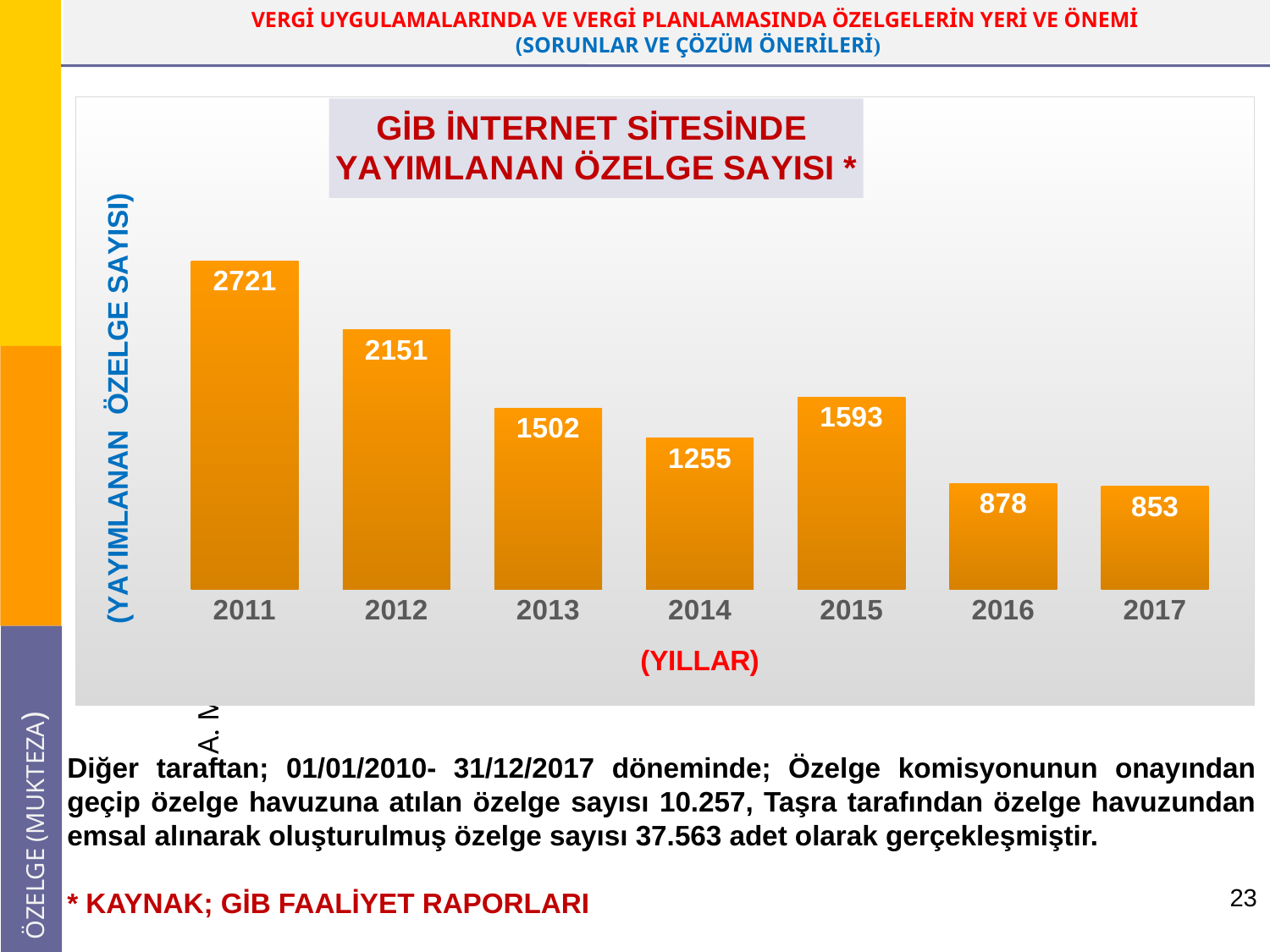
What is the value shown for 2017? 853 What kind of chart is shown on the slide? bar chart Which year has the lowest number of özelge published? 2017 What is the title of the chart? GİB İNTERNET SİTESİNDE YAYIMLANAN ÖZELGE SAYISI * What is the value shown for 2014? 1255 What is the difference between the values for 2011 and 2012? 570 What is the difference between the values for 2015 and 2016? 715 Which is larger, the value for 2014 or the value for 2015? 2015 How many years are shown on the x axis of the chart? 7 Do the values generally rise or fall from 2011 to 2017? fall What is the number of özelge published in 2011? 2721 Which year has the highest number of özelge published? 2011